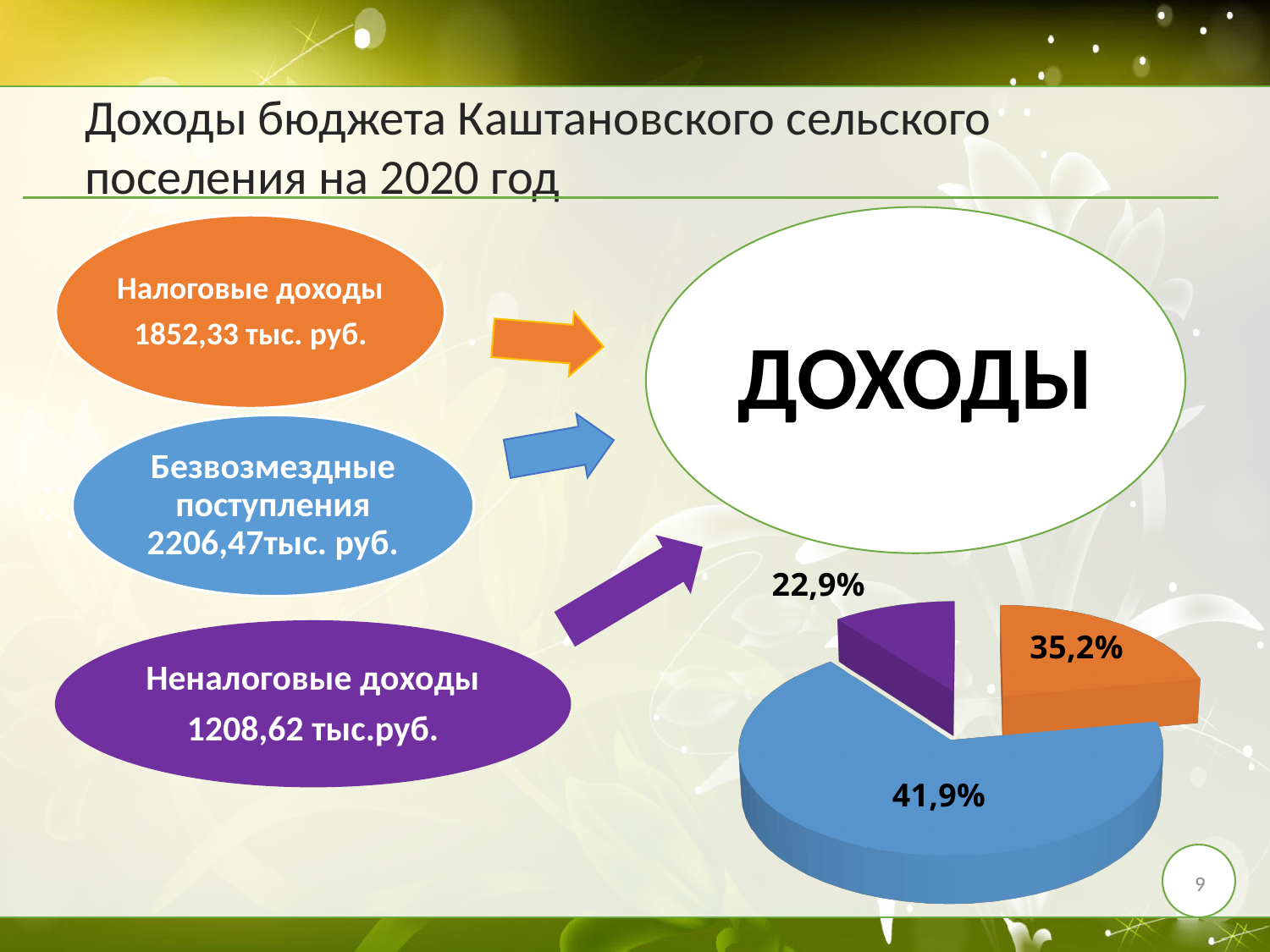
What word is written in the large white oval above the pie chart? ДОХОДЫ Which colour slice in the pie chart matches the colour of the oval labelled 'Безвозмездные поступления'? blue What percentage is shown on the purple slice of the pie chart? 22,9% What percentage is shown on the blue slice of the pie chart? 41,9% What is the difference in percentage points between the blue slice and the orange slice of the pie chart? 6,7 Which is larger in the pie chart, the orange slice or the purple slice? the orange slice What is the difference in percentage points between the orange slice and the purple slice of the pie chart? 12,3 Which slice of the pie chart is the largest? the blue slice (41,9%) Which slice of the pie chart is the smallest? the purple slice (22,9%) What kind of chart is shown on the slide? pie chart What percentage is shown on the orange slice of the pie chart? 35,2% How many slices does the pie chart have? 3